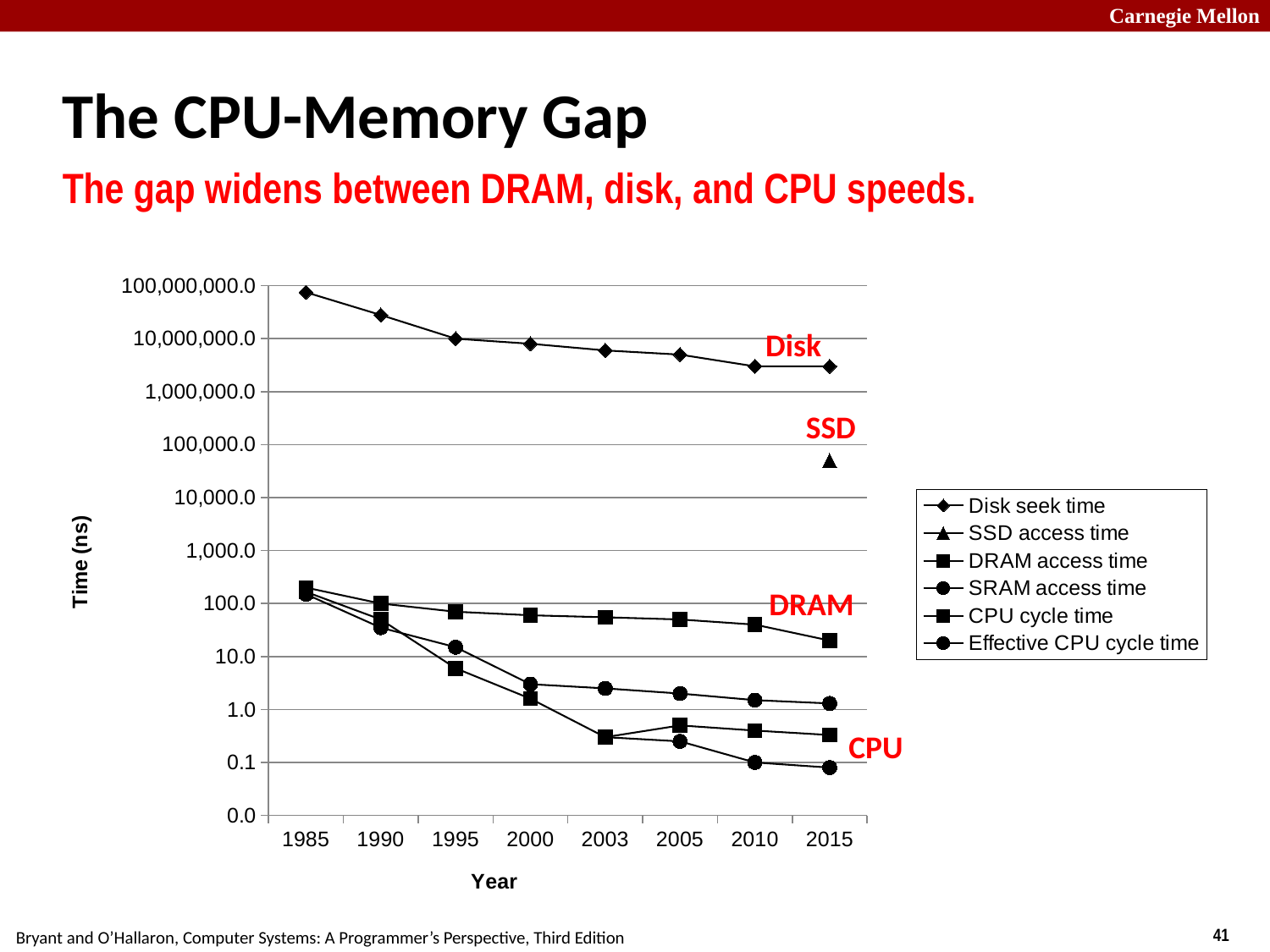
Which series has the highest value in 2015? Disk seek time What is the label on the y axis? Time (ns) Is the Disk seek time in 1985 greater or less than 10,000,000.0? greater Which is larger in 2015, the DRAM access time or the SRAM access time? DRAM access time How many series does the legend list? 6 Does the Disk seek time rise or fall from 1985 to 2015? fall What kind of chart is shown on the slide? line chart Is the SSD access time in 2015 greater or less than 100,000.0? less Which series has the lowest value in 2015? Effective CPU cycle time Is the CPU cycle time in 2015 greater or less than 1.0? less How many years are plotted along the x axis? 8